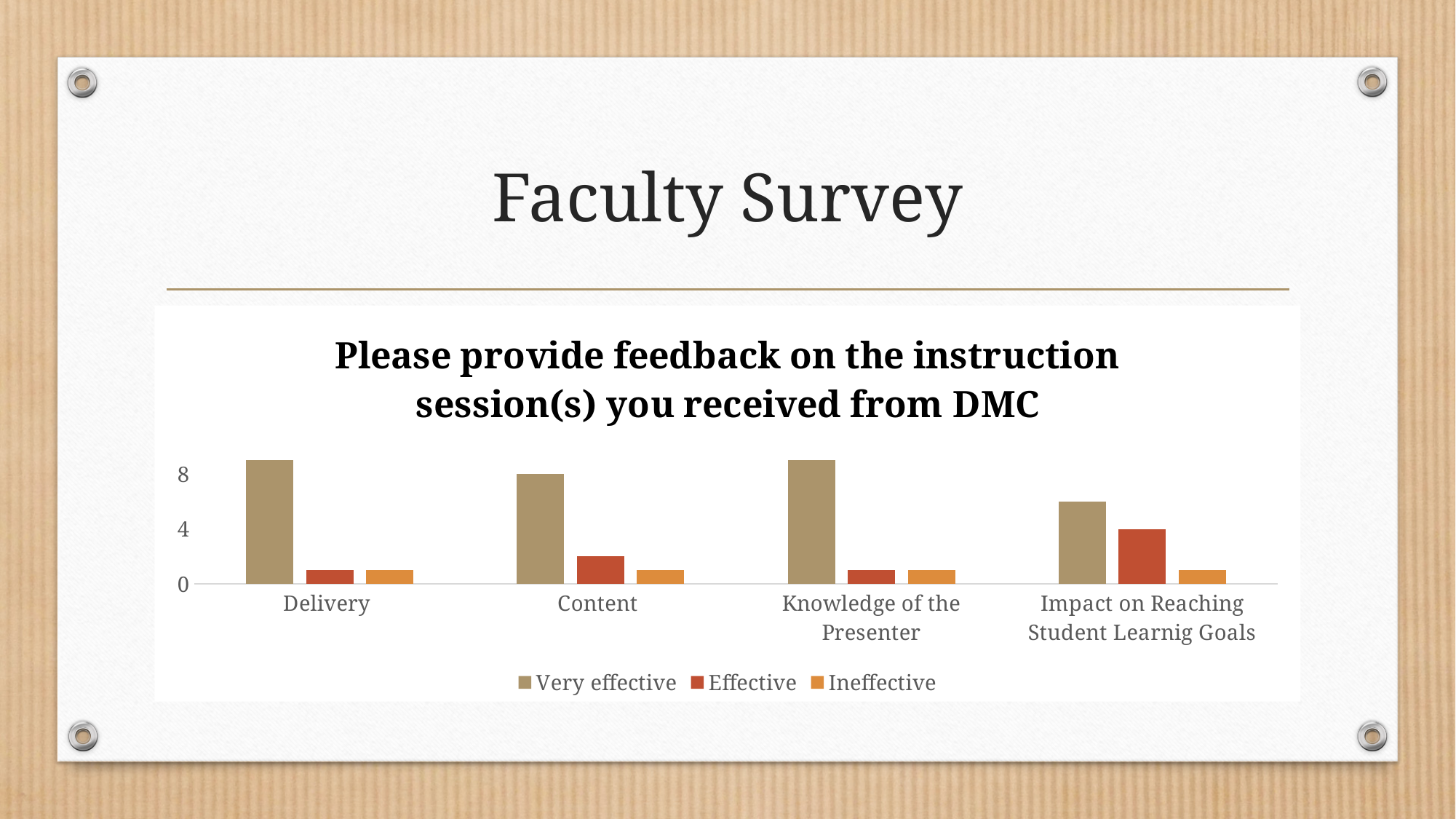
Is the Very effective value for Impact on Reaching Student Learnig Goals greater or less than 8? less Is the Very effective value for Delivery greater or less than 8? greater Which category has the highest Effective value? Impact on Reaching Student Learnig Goals How many categories are shown on the x axis of the chart? 4 What is the title of the chart? Please provide feedback on the instruction session(s) you received from DMC Which category has the lowest Very effective value? Impact on Reaching Student Learnig Goals What kind of chart is shown on the slide? bar chart How many series does the chart's legend list? 3 Is the Effective value for Content greater or less than 4? less What is the value of the Very effective bar for Content? 8 Which is larger: the Very effective value for Delivery or the Very effective value for Impact on Reaching Student Learnig Goals? Delivery What is the value of the Effective bar for Impact on Reaching Student Learnig Goals? 4